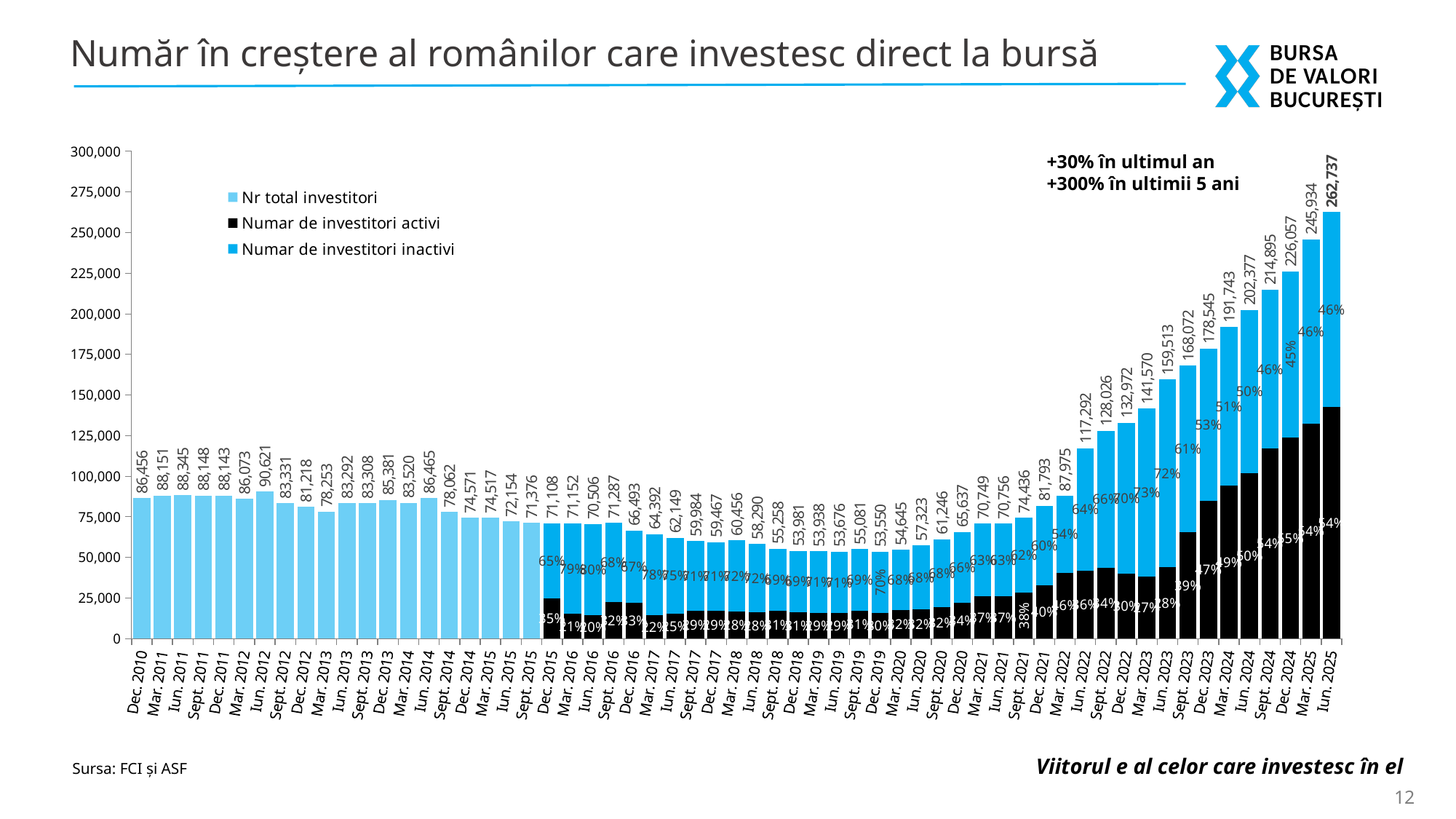
Which period has the highest total number of investors? Iun. 2025 According to the annotation on the chart, by what percentage did the number of investors grow in the last year? +30% What is the total number of investors shown for Iun. 2025? 262,737 Do the total investor values rise or fall from Iun. 2022 to Iun. 2025? rise What is the difference between the total number of investors in Iun. 2025 and Mar. 2025? 16,803 How many series does the legend list? 3 What is the total number of investors shown for Dec. 2010? 86,456 Is the number of active investors (black bar) in Iun. 2025 greater or less than 125,000? greater Which period has the lowest total number of investors? Dec. 2019 What kind of chart is shown on the slide? bar chart Which is larger, the total number of investors in Iun. 2012 or in Iun. 2014? Iun. 2012 What is the total number of investors shown for Iun. 2022? 117,292